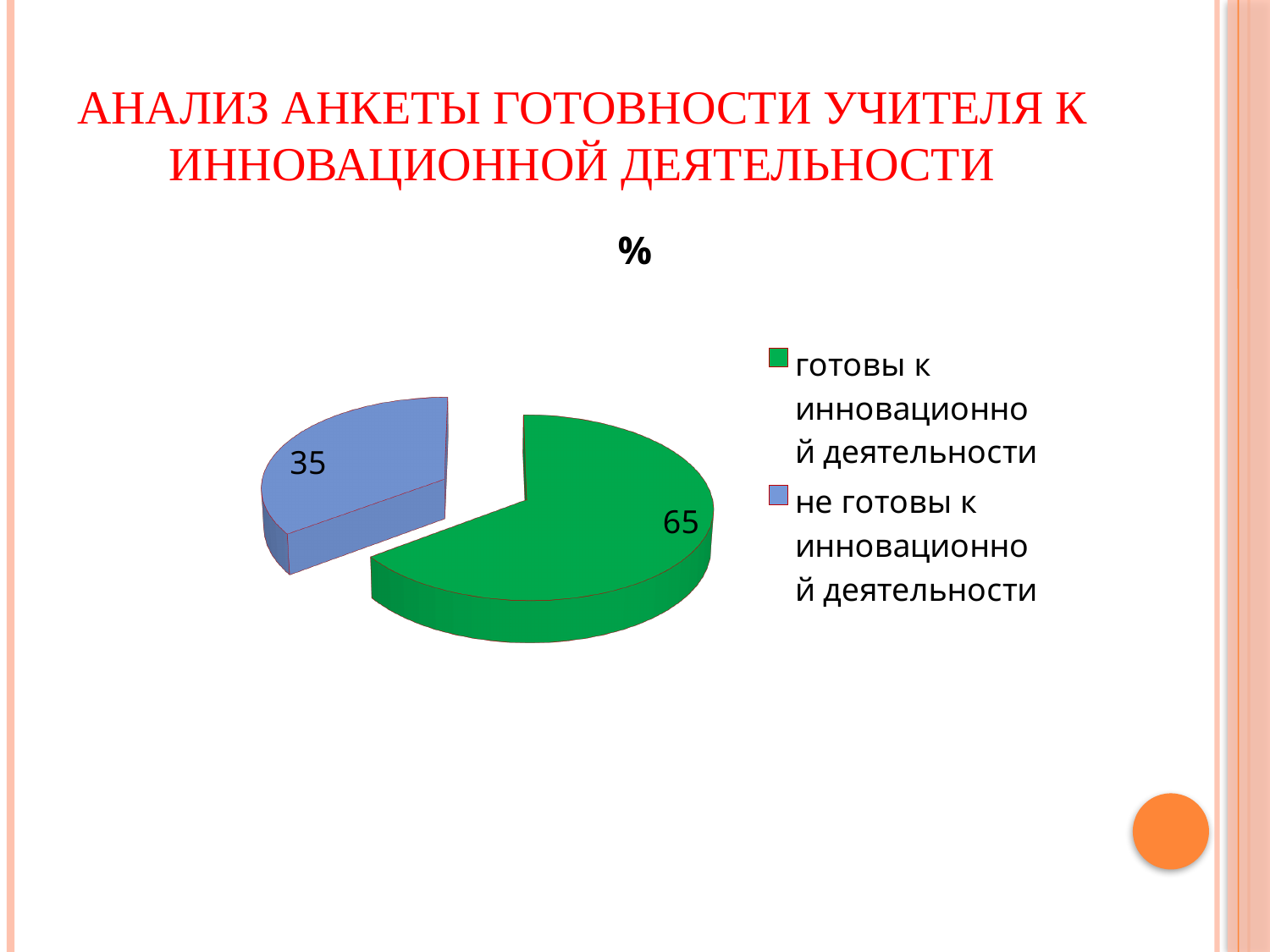
Which category has the largest slice? готовы к инновационной деятельности What share of the pie does "готовы к инновационной деятельности" represent? 65% Which is larger: the value for "готовы к инновационной деятельности" or for "не готовы к инновационной деятельности"? готовы к инновационной деятельности What colour is the slice for "не готовы к инновационной деятельности"? blue How many slices does the pie chart have? 2 What is the difference between the values for "готовы к инновационной деятельности" and "не готовы к инновационной деятельности"? 30 What is the value for "готовы к инновационной деятельности"? 65 What kind of chart is shown on the slide? pie chart How many entries does the legend list? 2 What is the title of the chart? % What is the value for "не готовы к инновационной деятельности"? 35 Which category has the smallest slice? не готовы к инновационной деятельности